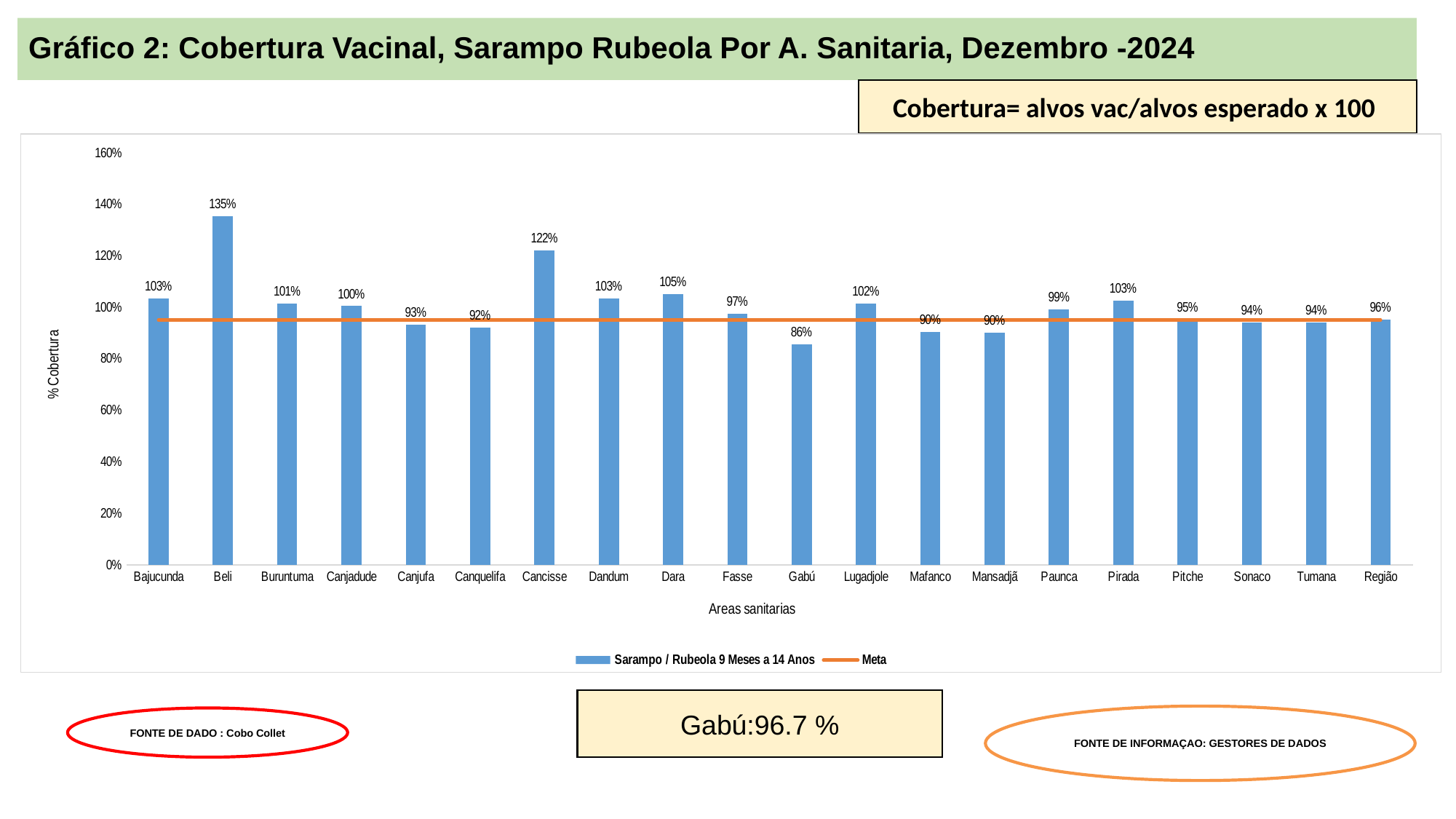
How many series does the legend list? 2 Is the value for Cancisse greater or less than 120%? greater What is the name of the series drawn as an orange line? Meta What is the vaccination coverage value for Beli? 135% What is the coverage value shown for Região? 96% Which health area has the highest coverage? Beli Which has a higher coverage, Dara or Fasse? Dara What is the difference between the coverage for Beli and the coverage for Cancisse? 13% What kind of chart is used to show the coverage values? bar chart Which health area has the lowest coverage? Gabú How many health areas (categories) are shown on the x axis? 20 What is the vaccination coverage value for Gabú? 86%